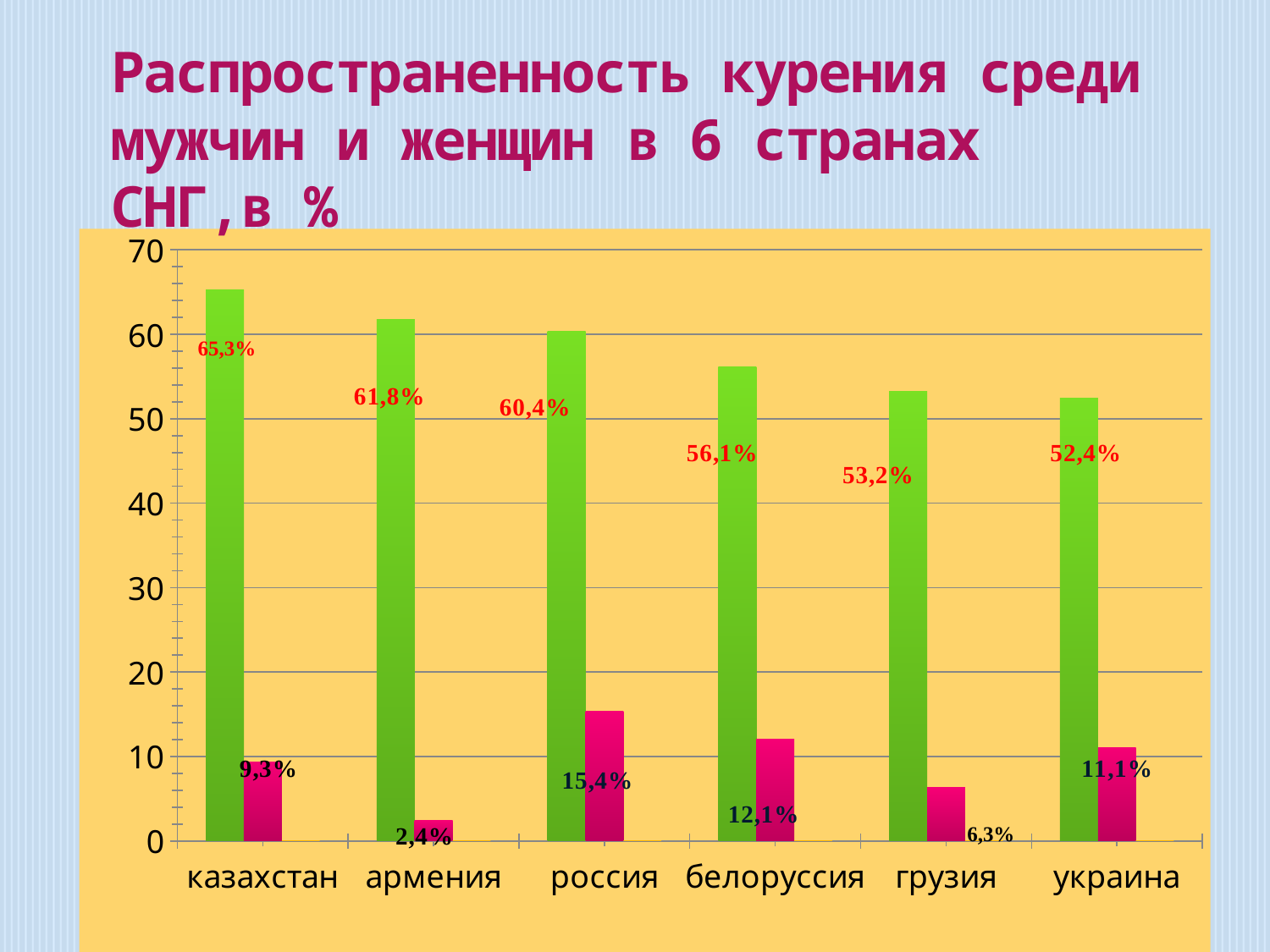
What is the value of the green bar for грузия? 53,2% Which country has the lowest magenta bar? армения What is the value of the magenta bar for россия? 15,4% What is the difference between the green bar and the magenta bar for украина? 41,3% Which is larger: the magenta bar for белоруссия or the magenta bar for грузия? белоруссия What type of chart is shown on the slide? bar chart What is the value of the green bar for казахстан? 65,3% Which country has the highest green bar? казахстан Which country has the highest magenta bar? россия How many countries are shown on the x axis? 6 What is the value of the magenta bar for армения? 2,4% Do the green bars rise or fall from казахстан to украина? fall